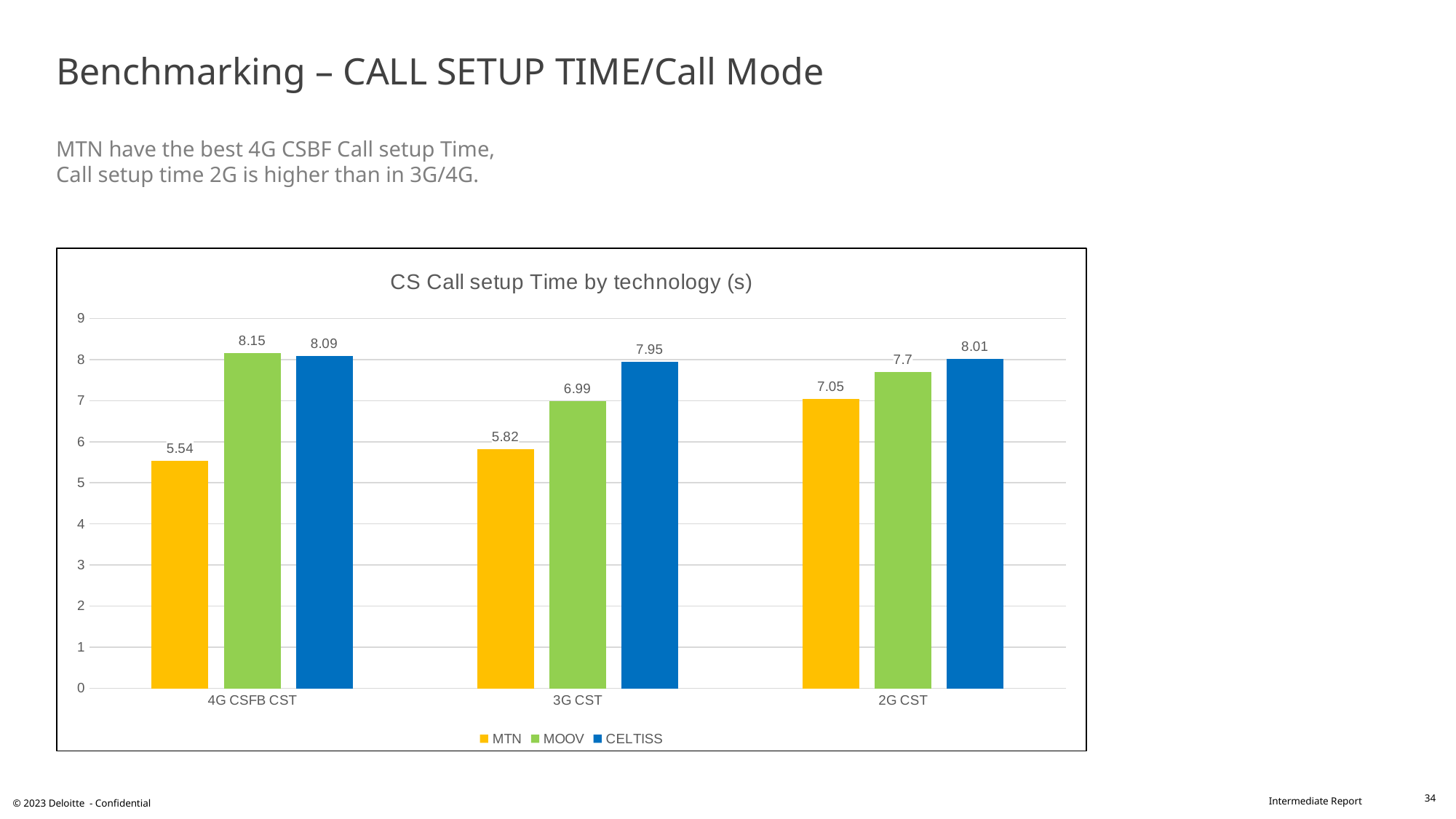
What is the MOOV value for 2G CST? 7.7 Is the MTN value for 3G CST greater or less than 6? less What is the title of the chart? CS Call setup Time by technology (s) What is the MTN value for 4G CSFB CST? 5.54 Which series has the highest value for 4G CSFB CST? MOOV What is the CELTISS value for 3G CST? 7.95 What is the difference between the CELTISS and MTN values for 2G CST? 0.96 How many categories are shown on the x axis? 3 Which is larger, the MOOV value for 3G CST or the MOOV value for 2G CST? 2G CST How many series does the legend list? 3 What kind of chart is shown? bar chart Which series has the lowest value for 3G CST? MTN